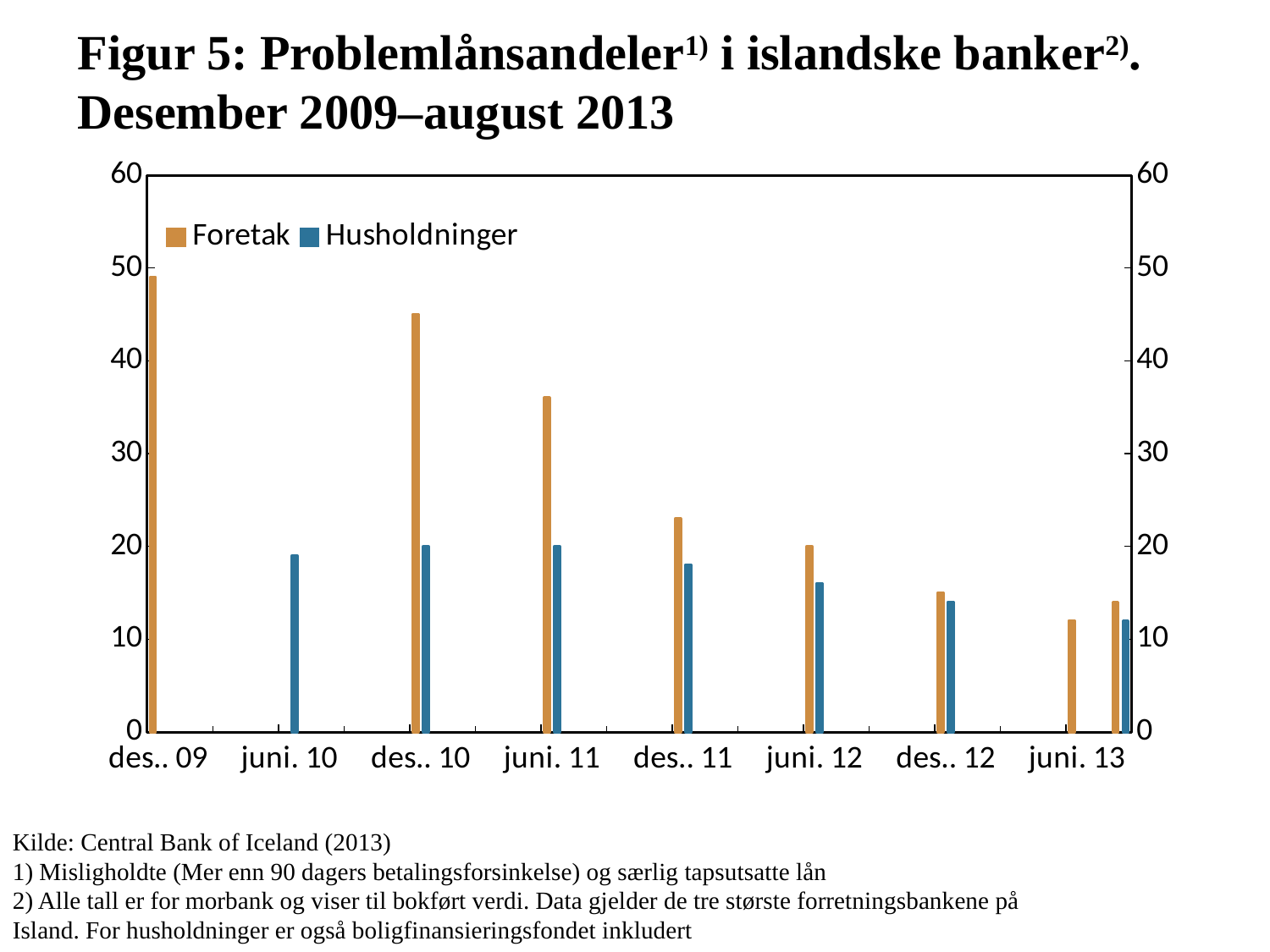
Does the Foretak series generally rise or fall from des.. 09 to juni. 13? fall At des.. 11, which series has the larger value, Foretak or Husholdninger? Foretak At which date is the Foretak value highest? des.. 09 How many series does the legend list? 2 Is the Foretak value for juni. 11 greater or less than 30? greater What are the two series named in the legend? Foretak and Husholdninger Is the Husholdninger value for juni. 12 greater or less than 20? less Is the Foretak value for des.. 09 greater or less than 40? greater What kind of chart is shown on the slide? bar chart